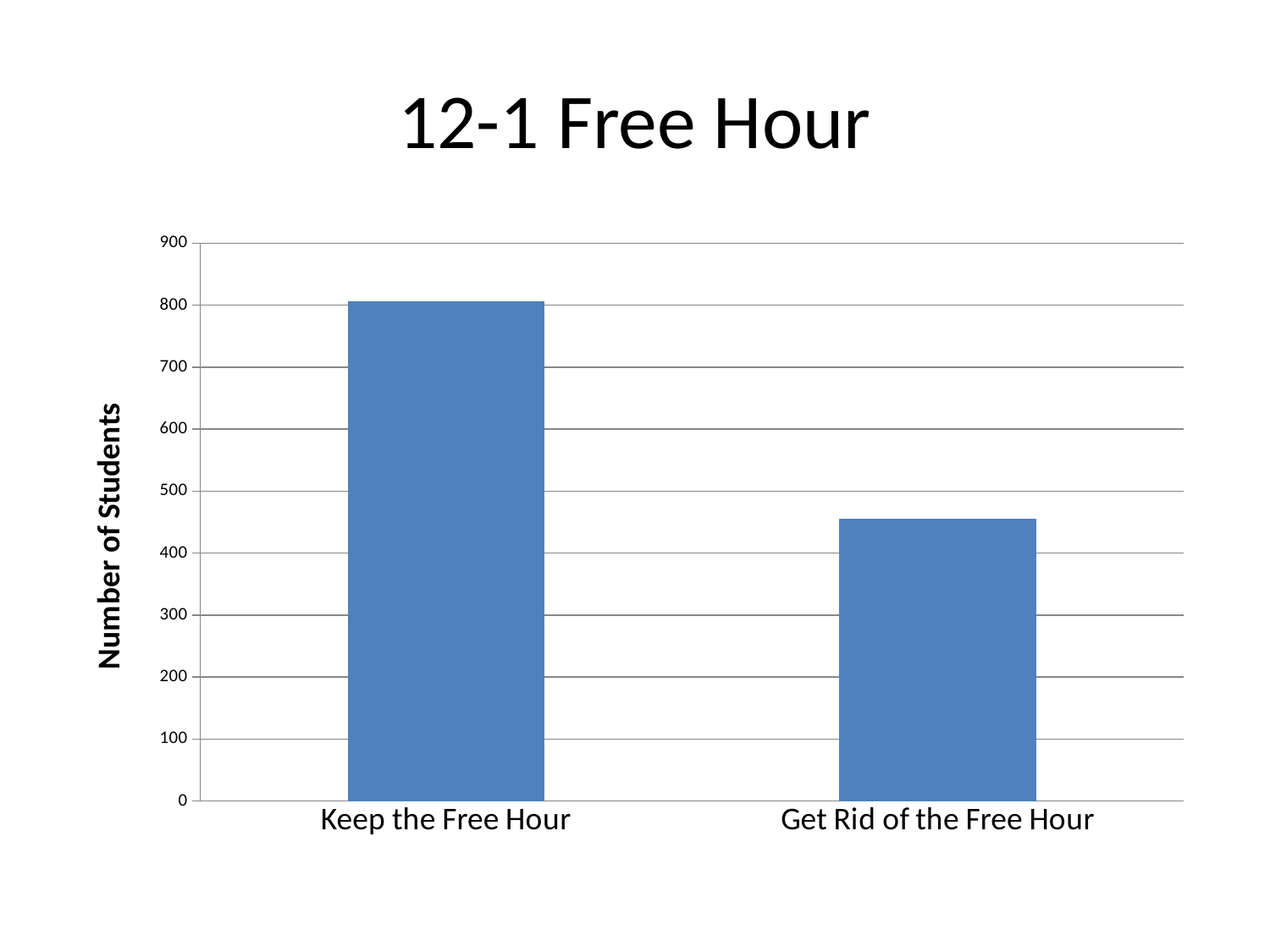
What is the title of the slide? 12-1 Free Hour Which category has the highest number of students? Keep the Free Hour Which category has the lowest number of students? Get Rid of the Free Hour Which is larger, the value for Keep the Free Hour or the value for Get Rid of the Free Hour? Keep the Free Hour How many categories are shown on the x axis? 2 Is the value for Keep the Free Hour greater or less than 700? greater What kind of chart is shown on the slide? bar chart What is the label on the vertical axis? Number of Students Is the value for Get Rid of the Free Hour greater or less than 400? greater Is the value for Keep the Free Hour greater or less than 900? less